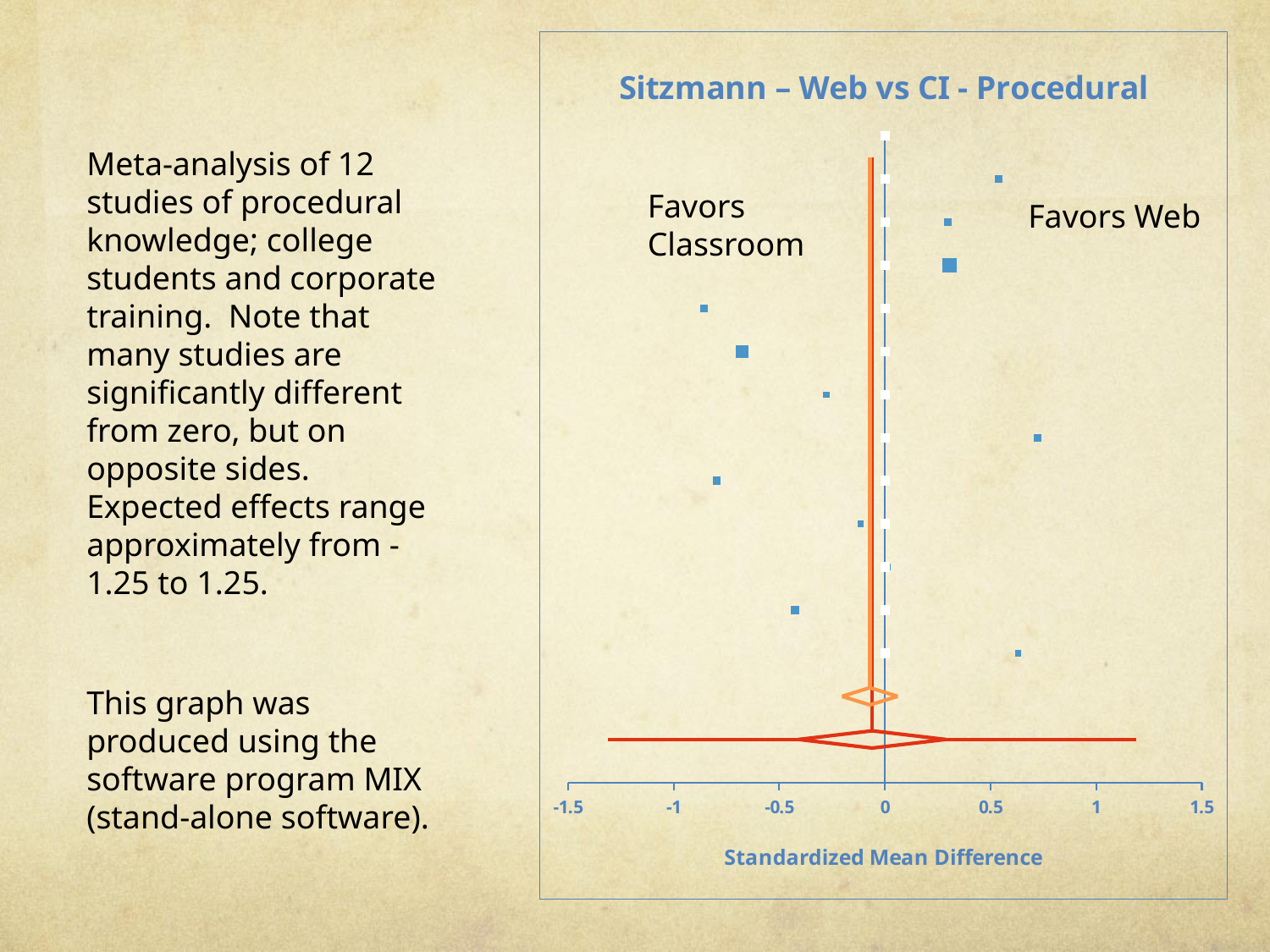
Is the value of the rightmost data point greater or less than 0.5? greater What is the lowest value labeled on the x axis? -1.5 Is the value of the leftmost data point greater or less than -0.5? less What is the title of the chart? Sitzmann – Web vs CI - Procedural How many data points (study markers) are plotted in the chart? 12 What is the highest value labeled on the x axis? 1.5 Is the value of the topmost data point greater or less than 0? greater What is the x-axis title of the chart? Standardized Mean Difference How many tick labels are shown on the x axis? 7 Which side of the chart is labeled 'Favors Web', the left or the right? Right What kind of chart is shown on the slide? Scatter chart